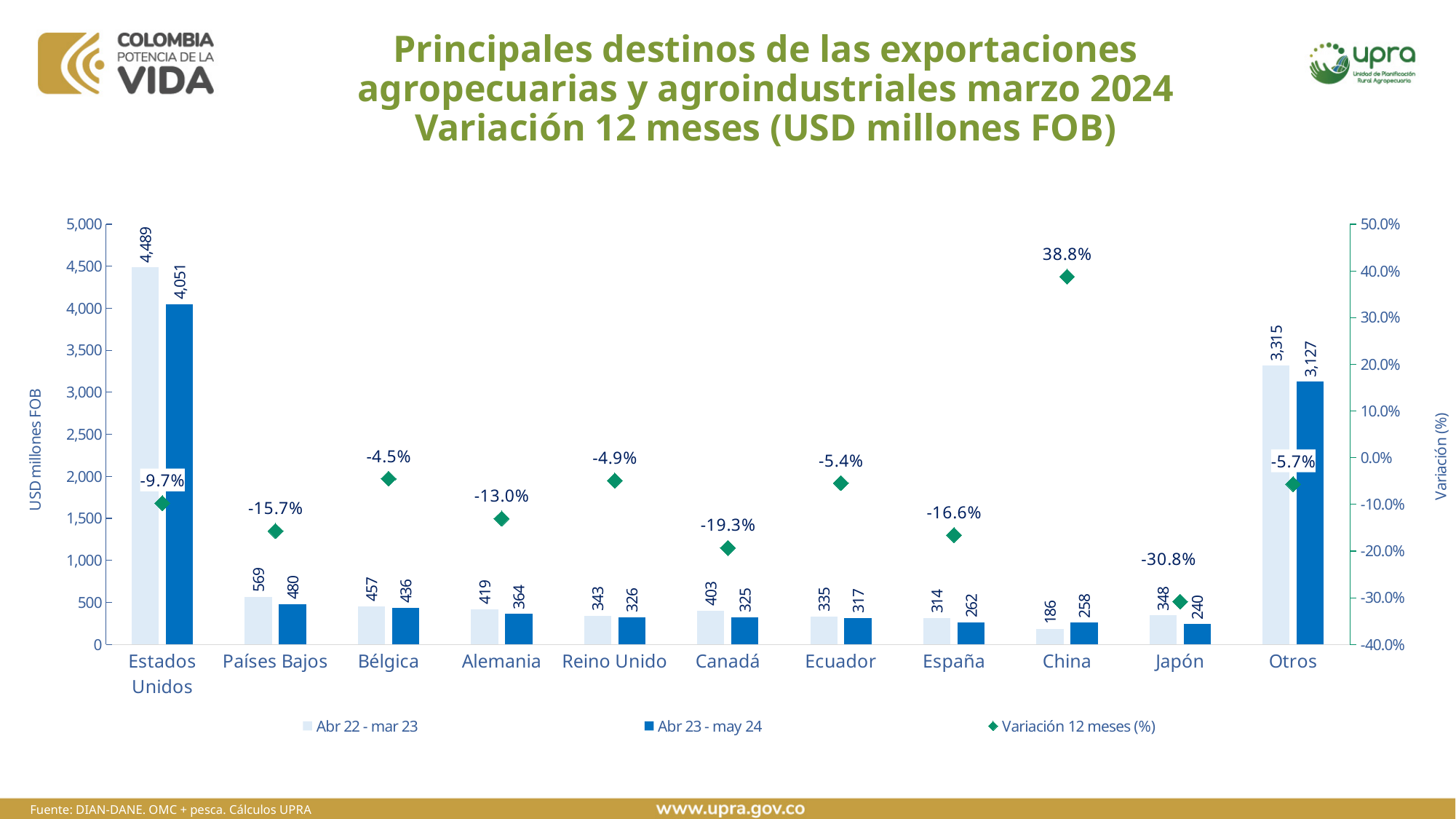
Which category has the lowest value in the Abr 23 - may 24 series? Japón Which category is the only one with a positive Variación 12 meses (%) value? China How many categories are shown on the x axis? 11 What is the Variación 12 meses (%) value for China? 38.8% What is the value for Estados Unidos in the Abr 23 - may 24 series? 4,051 What is the difference between the Abr 22 - mar 23 and Abr 23 - may 24 values for Estados Unidos? 438 Which country (excluding Otros) has the highest value in the Abr 22 - mar 23 series? Estados Unidos Is the Abr 23 - may 24 value for Otros greater or less than 3,000? greater Which is larger for China: the Abr 22 - mar 23 value or the Abr 23 - may 24 value? Abr 23 - may 24 How many series does the legend list? 3 What is the value for Países Bajos in the Abr 22 - mar 23 series? 569 What is the Variación 12 meses (%) value for Japón? -30.8%